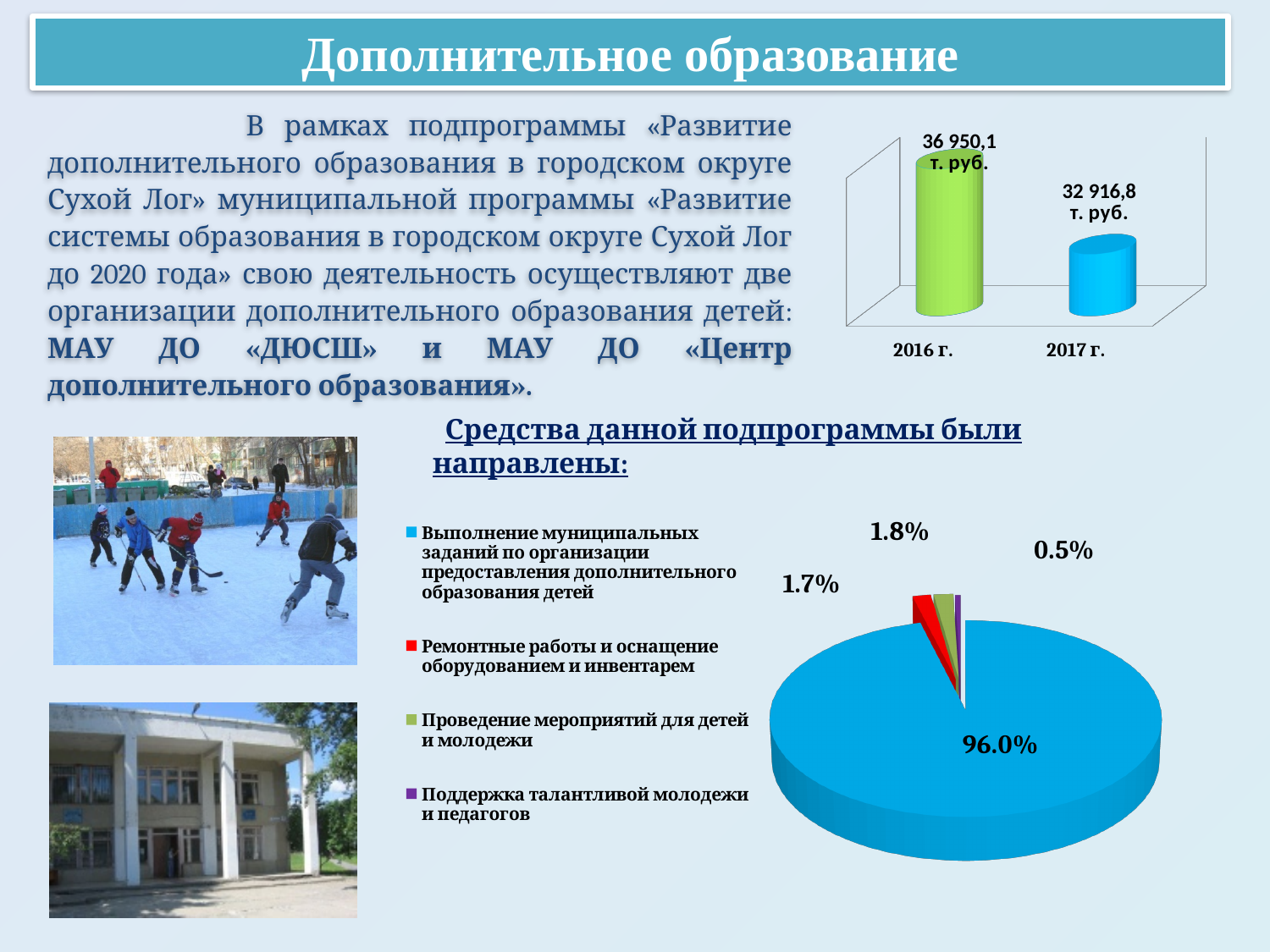
In the bar chart at the top right, what is the value for 2017 г.? 32 916,8 т. руб. How many entries does the legend of the pie chart at the bottom right list? 4 In the pie chart at the bottom right, what share is shown for 'Поддержка талантливой молодежи и педагогов'? 0.5% In the bar chart at the top right, what is the value for 2016 г.? 36 950,1 т. руб. In the pie chart at the bottom right, which category has the smallest slice? Поддержка талантливой молодежи и педагогов In the bar chart at the top right, by how much does the 2016 г. value exceed the 2017 г. value? 4 033,3 т. руб. How many categories are shown in the bar chart at the top right? 2 In the bar chart at the top right, which year has the lower value? 2017 г. In the pie chart at the bottom right, what share is shown for 'Выполнение муниципальных заданий по организации предоставления дополнительного образования детей'? 96.0% In the bar chart at the top right, which year has the higher value? 2016 г. What kind of chart is shown at the top right of the slide? bar chart In the bar chart at the top right, do the values rise or fall from 2016 г. to 2017 г.? fall